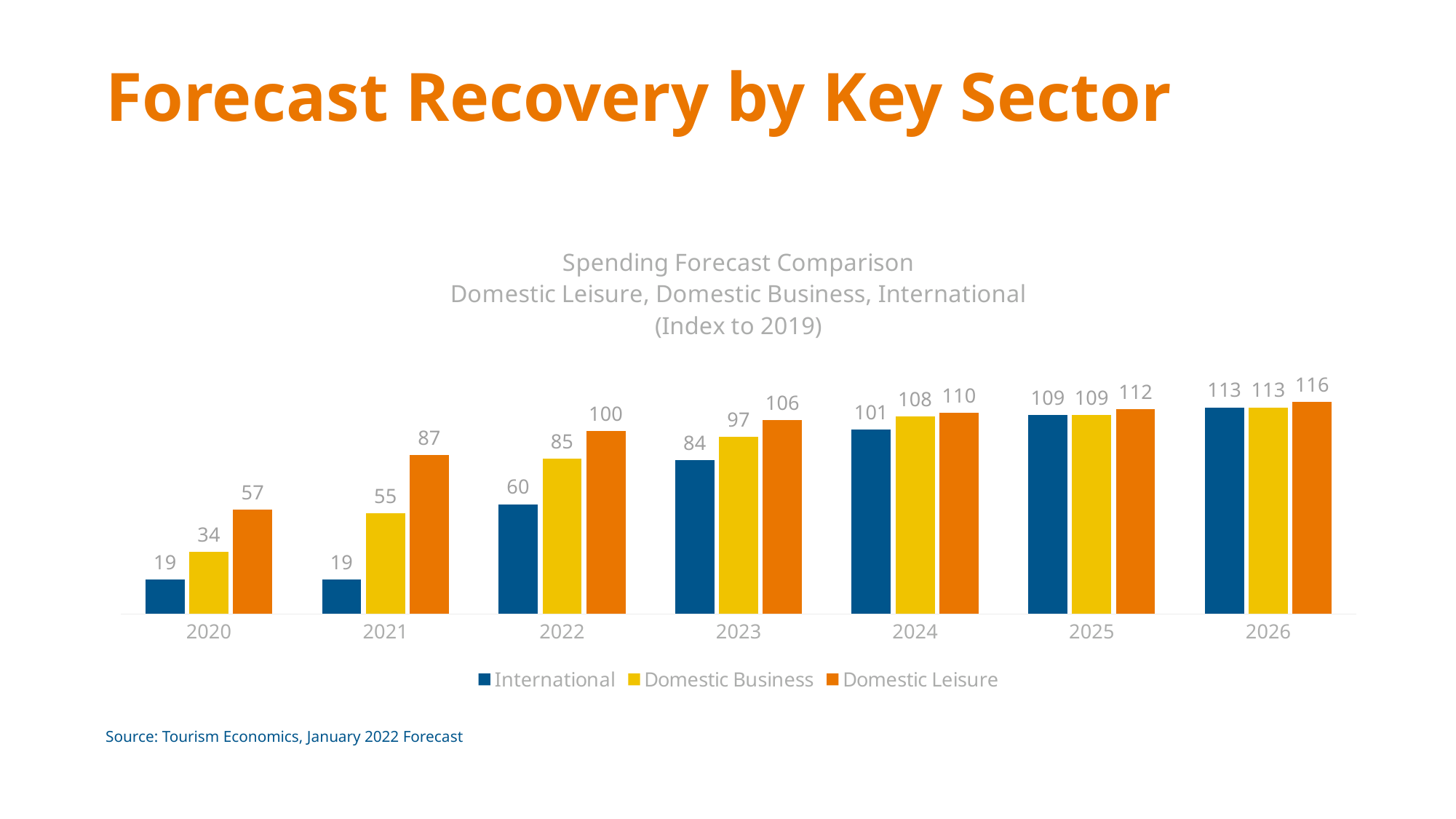
What is the International value for 2022? 60 Which is larger in 2023: Domestic Business or International? Domestic Business Which series is shown in dark blue in the legend? International In which year is the Domestic Leisure value highest? 2026 How many years are shown on the x axis? 7 How many series does the legend list? 3 What is the Domestic Business value for 2024? 108 What is the Domestic Leisure value for 2021? 87 What is the difference between the Domestic Leisure and International values in 2020? 38 What kind of chart is shown on the slide? Bar chart Does the International value rise or fall from 2020 to 2026? Rise In which year is the Domestic Business value lowest? 2020